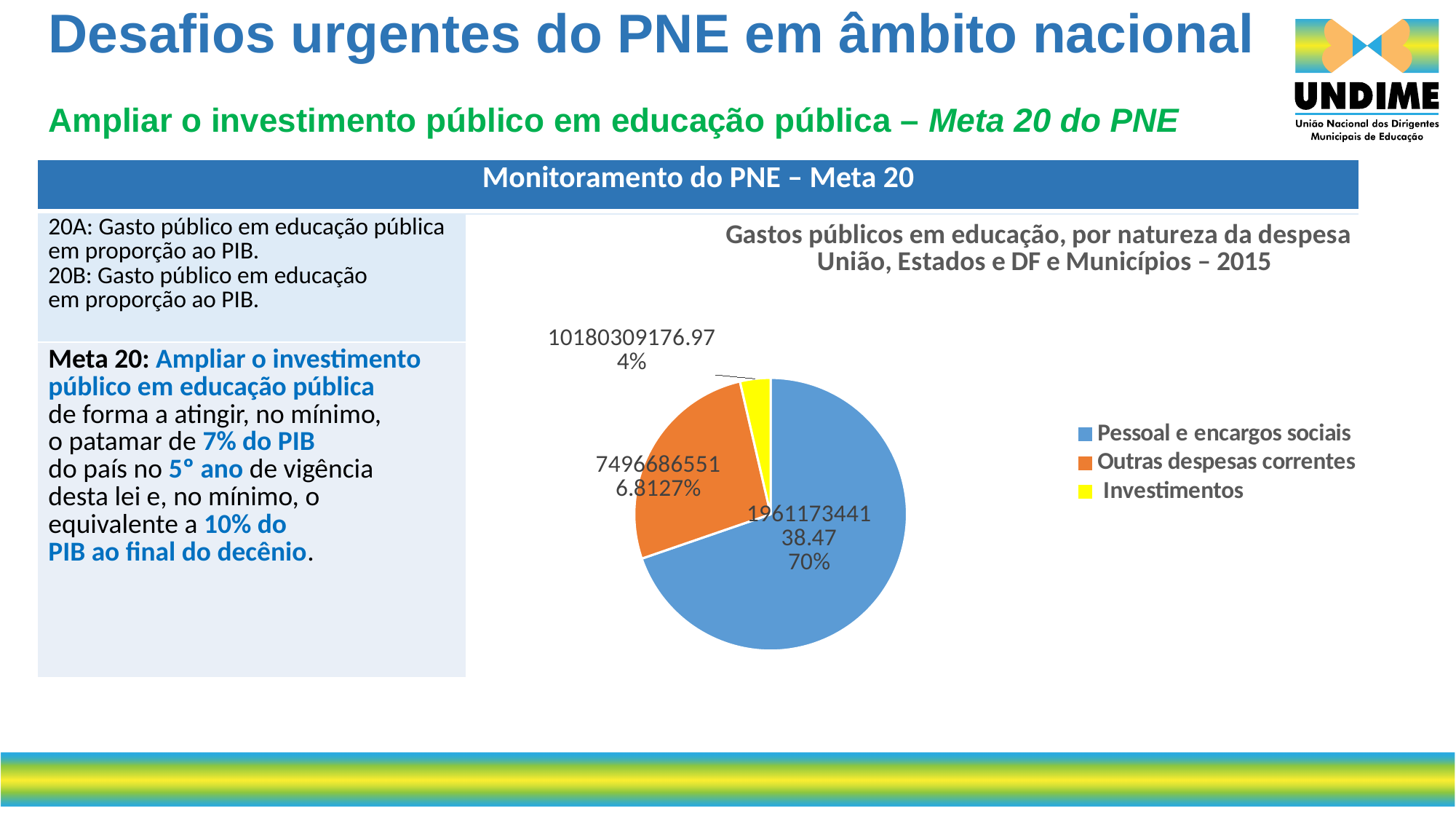
Which category has the smallest slice of the pie chart? Investimentos What share of the pie does Pessoal e encargos sociais represent? 70% Which slice is larger, Pessoal e encargos sociais or Outras despesas correntes? Pessoal e encargos sociais How many entries does the legend of the pie chart list? 3 How many slices does the pie chart have? 3 What kind of chart is shown on the slide? Pie chart Which category has the largest slice of the pie chart? Pessoal e encargos sociais Which slice is larger, Outras despesas correntes or Investimentos? Outras despesas correntes What value is printed for the Investimentos slice? 10180309176.97 What is the title of the pie chart? Gastos públicos em educação, por natureza da despesa União, Estados e DF e Municípios – 2015 Which colour represents Investimentos in the pie chart? Yellow What share of the pie does Investimentos represent? 4%